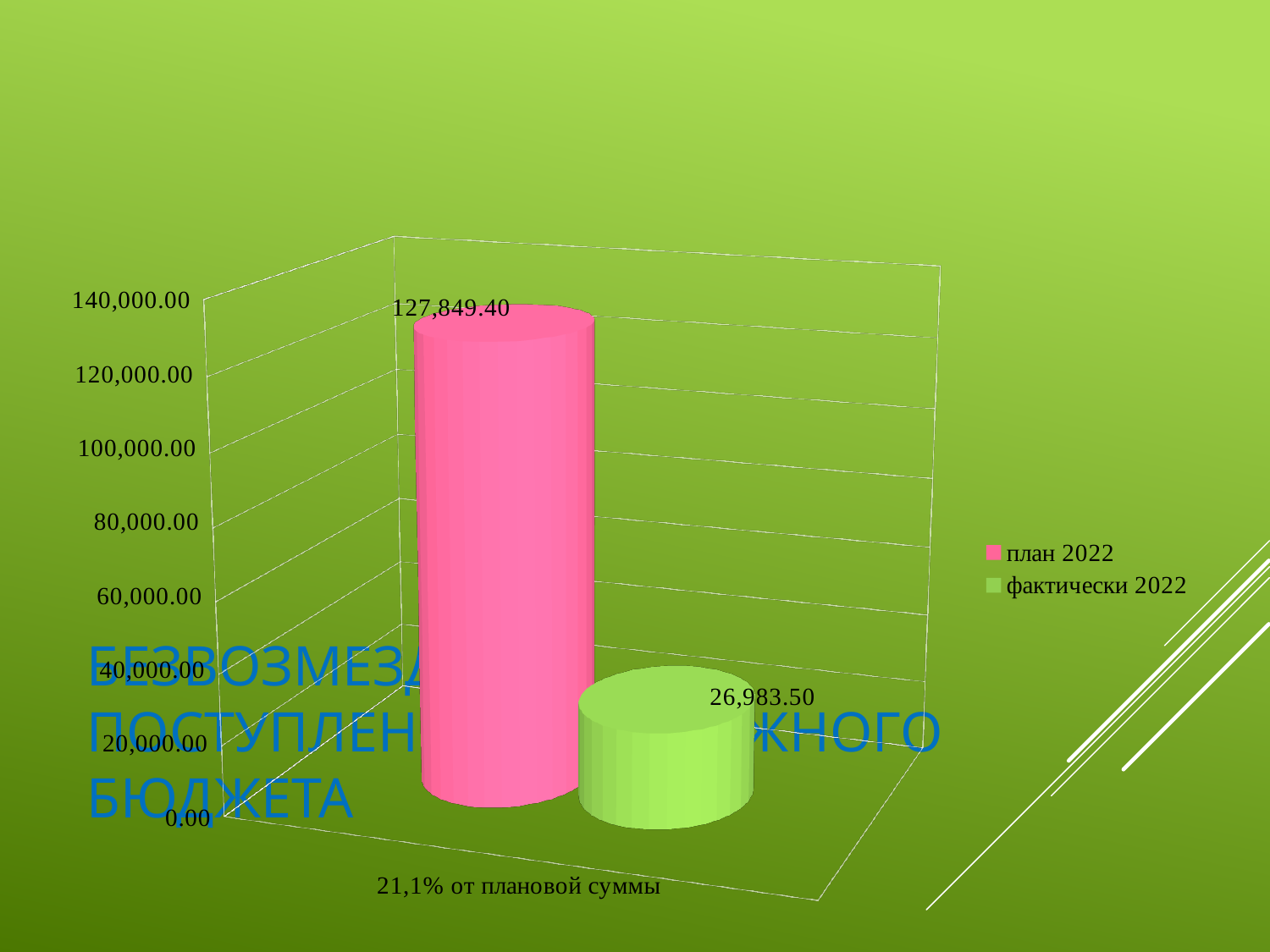
How many series does the legend list? 2 Is the value for план 2022 greater or less than 120,000.00? greater Is the value for фактически 2022 greater or less than 40,000.00? less Which series has the lowest value? фактически 2022 What is the category label shown below the bars? 21,1% от плановой суммы What is the difference between the план 2022 value and the фактически 2022 value? 100,865.90 Which series has the higher value, план 2022 or фактически 2022? план 2022 What kind of chart is shown on the slide? bar chart What is the value for фактически 2022? 26,983.50 Which series has the highest value? план 2022 What is the value for план 2022? 127,849.40 What colour is the bar for фактически 2022? green